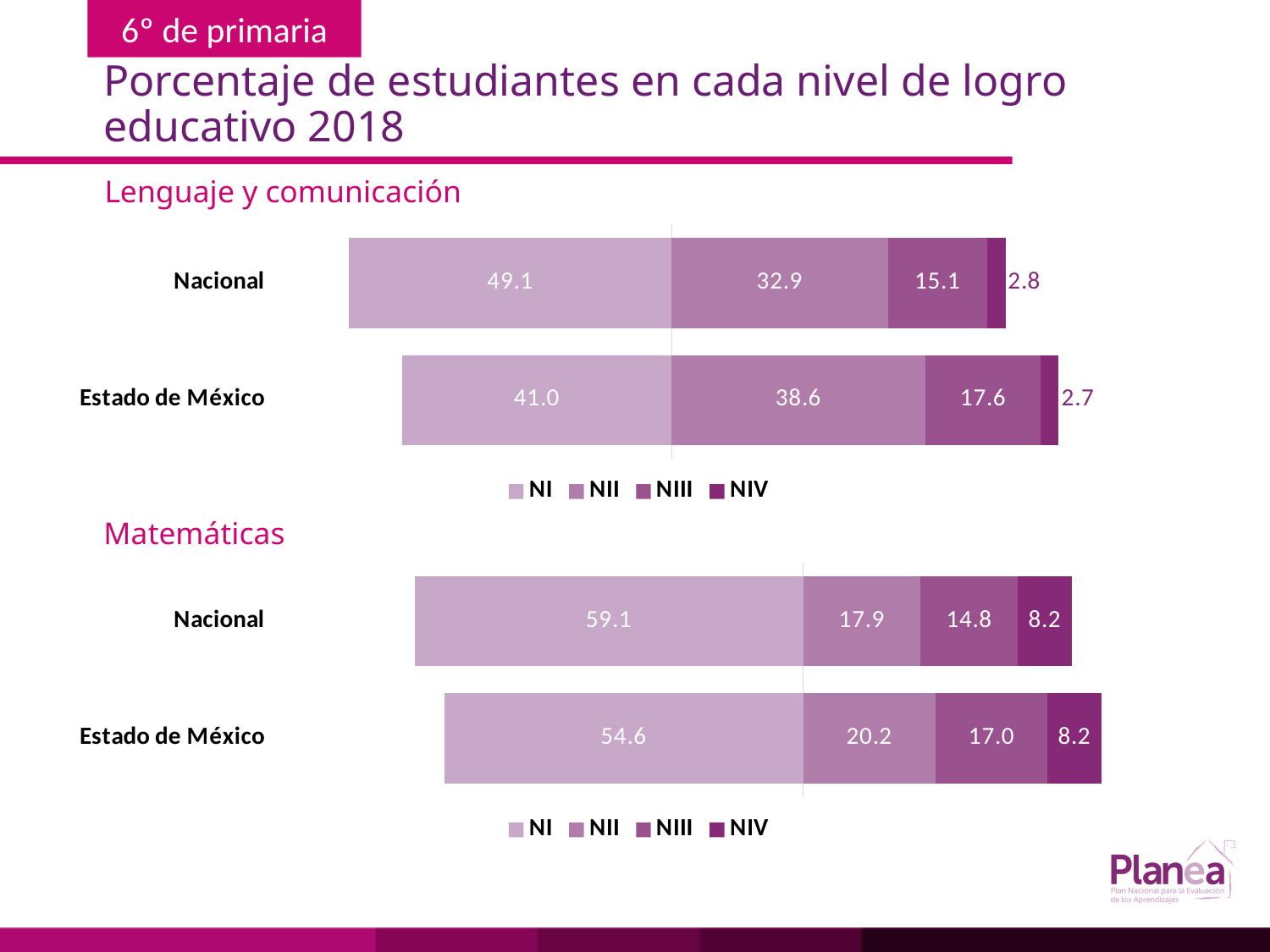
In the Lenguaje y comunicación chart, what is the difference between the NI values for Nacional and Estado de México? 8.1 In the Matemáticas chart, what is the difference between the NI values for Nacional and Estado de México? 4.5 How many series does the legend of the Lenguaje y comunicación chart list? 4 In the Lenguaje y comunicación chart, what is the NII value for Estado de México? 38.6 In the Matemáticas chart, what is the NIV value for Nacional? 8.2 In the Matemáticas chart, what is the NIII value for Estado de México? 17.0 What kind of chart is the Matemáticas chart? Stacked bar chart In the Matemáticas chart, what is the total of the stacked bar for Nacional? 100.0 In the Lenguaje y comunicación chart, what is the NI value for Nacional? 49.1 In the Lenguaje y comunicación chart, which level has the lowest value for Nacional? NIV In the Matemáticas chart, which is larger, the NII value for Nacional or for Estado de México? Estado de México In the Matemáticas chart, which level has the highest value for Estado de México? NI